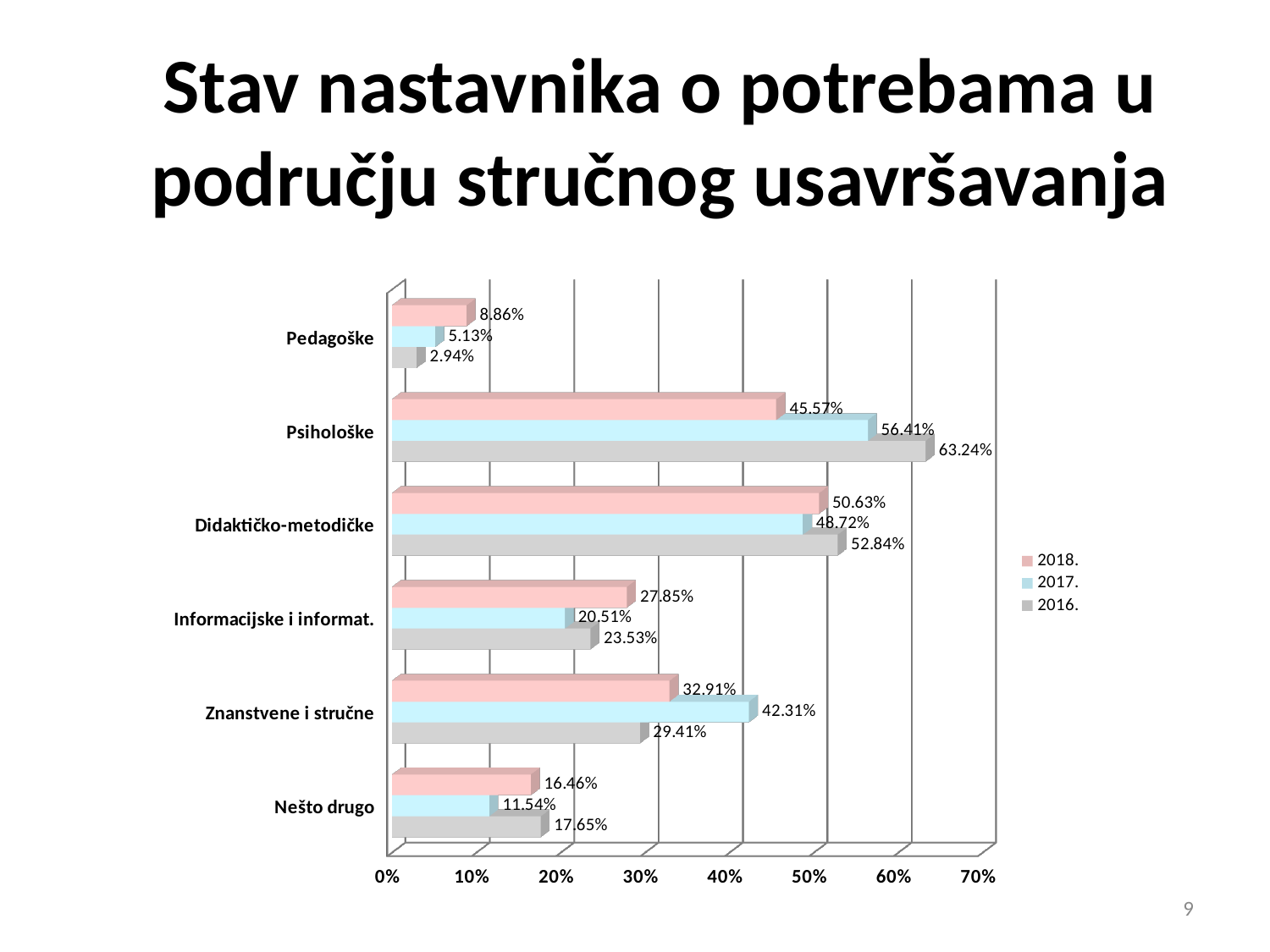
What is the value for Znanstvene i stručne in the 2017. series? 42.31% What kind of chart is shown on the slide? bar chart How many series does the legend list? 3 What is the value for Psihološke in the 2016. series? 63.24% Which category has the highest value in the 2018. series? Didaktičko-metodičke Which category has the lowest value in the 2016. series? Pedagoške What is the difference between the 2016. and 2018. values for Psihološke? 17.67% Which series is shown in pink in the legend? 2018. Is the 2017. value for Psihološke greater or less than 50%? greater Which is larger for Informacijske i informat.: the 2017. value or the 2016. value? 2016. What is the value for Nešto drugo in the 2018. series? 16.46% How many categories are shown on the chart? 6